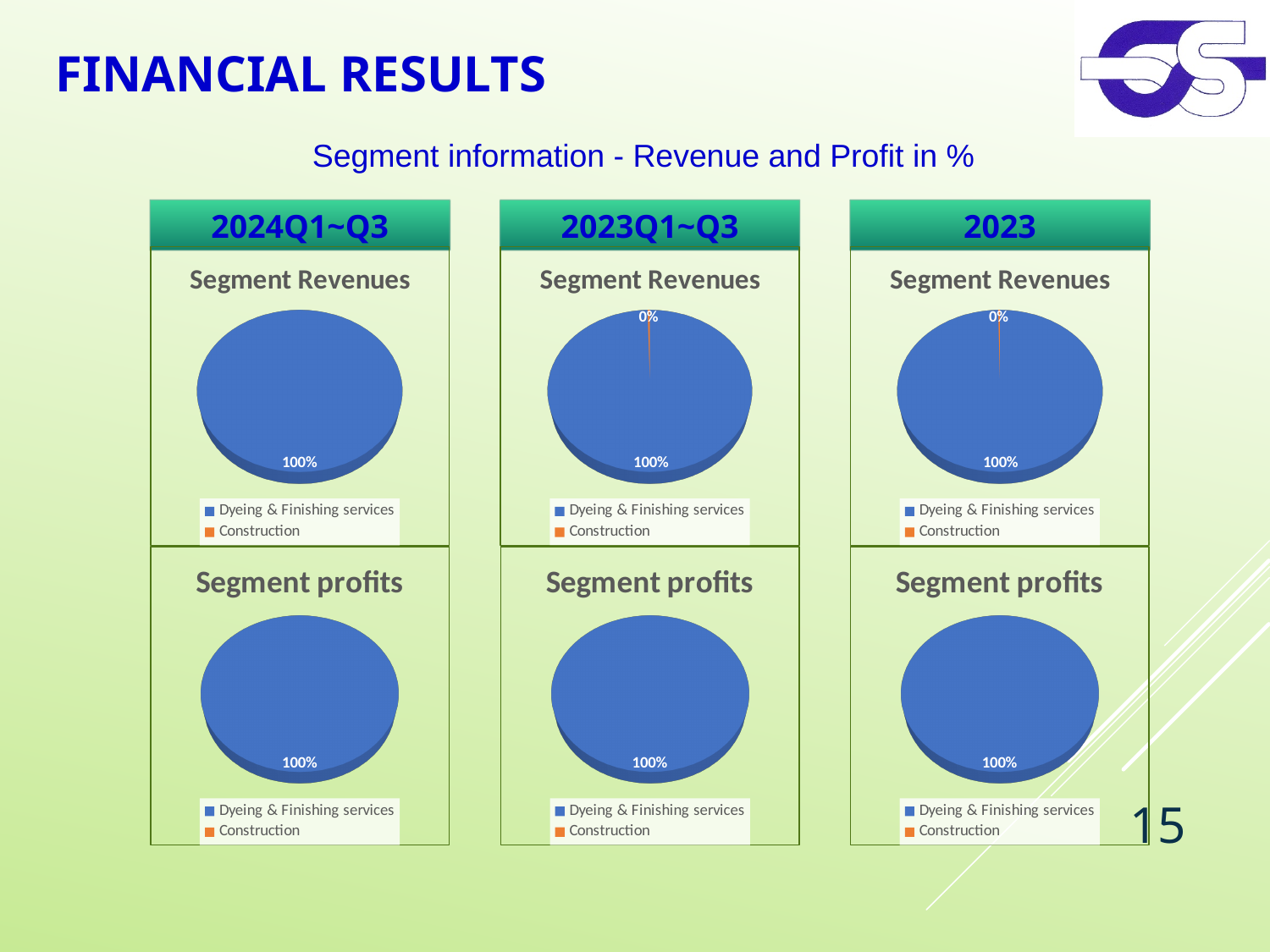
How many pie charts are shown on the slide? 6 How many entries does the legend of the 2024Q1~Q3 Segment Revenues chart list? 2 In the 2023 Segment Revenues chart, what share is labelled for Dyeing & Finishing services? 100% In the 2023Q1~Q3 Segment profits chart, what share is labelled for Dyeing & Finishing services? 100% In the 2023 Segment profits chart, which segment has the largest share? Dyeing & Finishing services What kind of chart is used for the 2024Q1~Q3 Segment Revenues? Pie chart In the 2023 Segment Revenues chart, what share is labelled for Construction? 0% What colour represents Construction in the legends of the charts? Orange In the 2023Q1~Q3 Segment Revenues chart, which segment has the smallest share? Construction